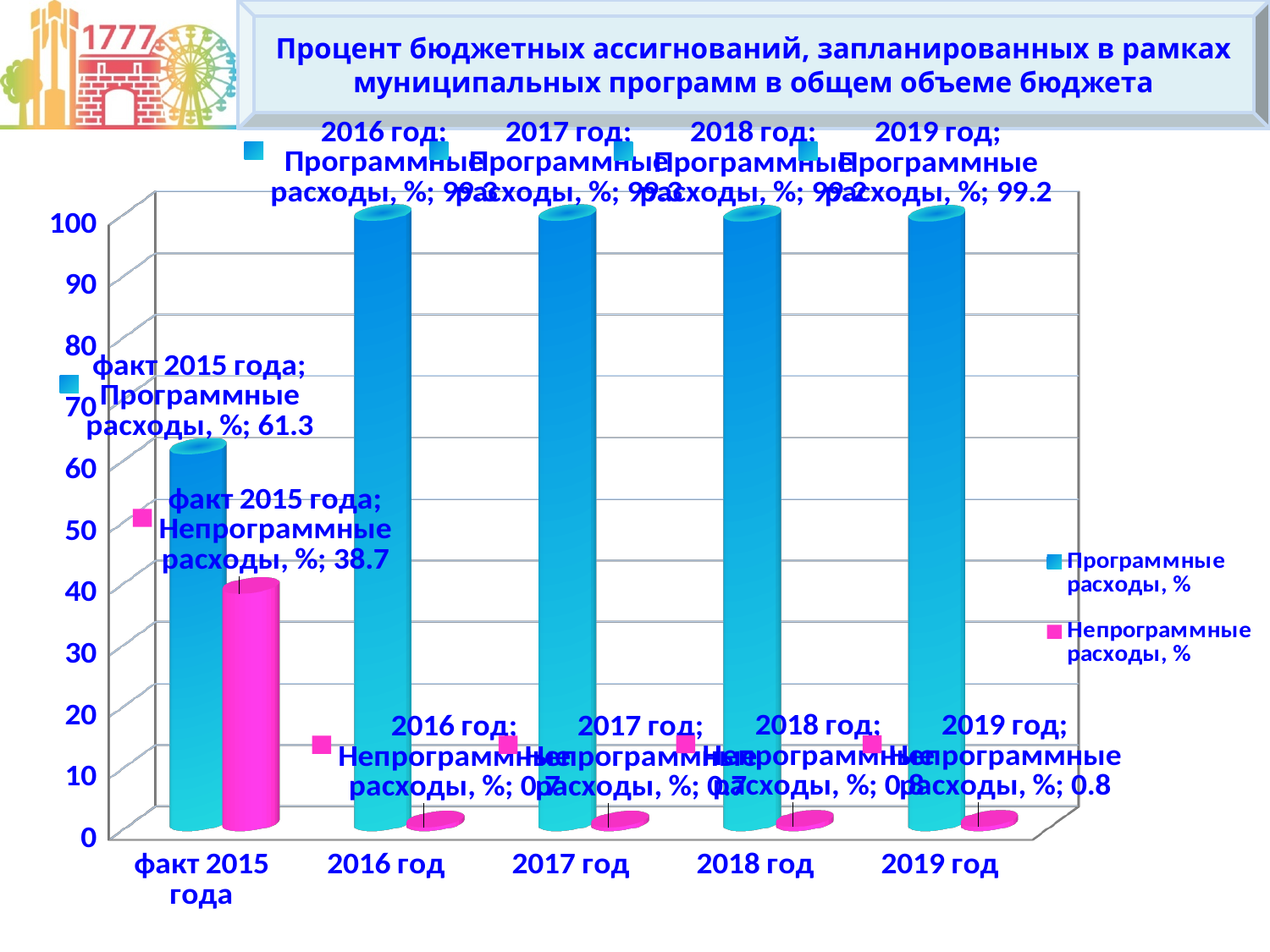
Which category has the highest value for Непрограммные расходы, %? факт 2015 года Is the value of Программные расходы, % for 2016 год greater or less than 90? greater What is the difference between Программные расходы, % and Непрограммные расходы, % for факт 2015 года? 22.6 What is the value of Программные расходы, % for факт 2015 года? 61.3 What is the value of Программные расходы, % for 2019 год? 99.2 Which colour represents Непрограммные расходы, % in the legend? pink What kind of chart is shown on the slide? bar chart What is the value of Непрограммные расходы, % for факт 2015 года? 38.7 How many categories are shown on the x axis? 5 Which category has the lowest value for Программные расходы, %? факт 2015 года What is the value of Непрограммные расходы, % for 2019 год? 0.8 How many series does the legend list? 2